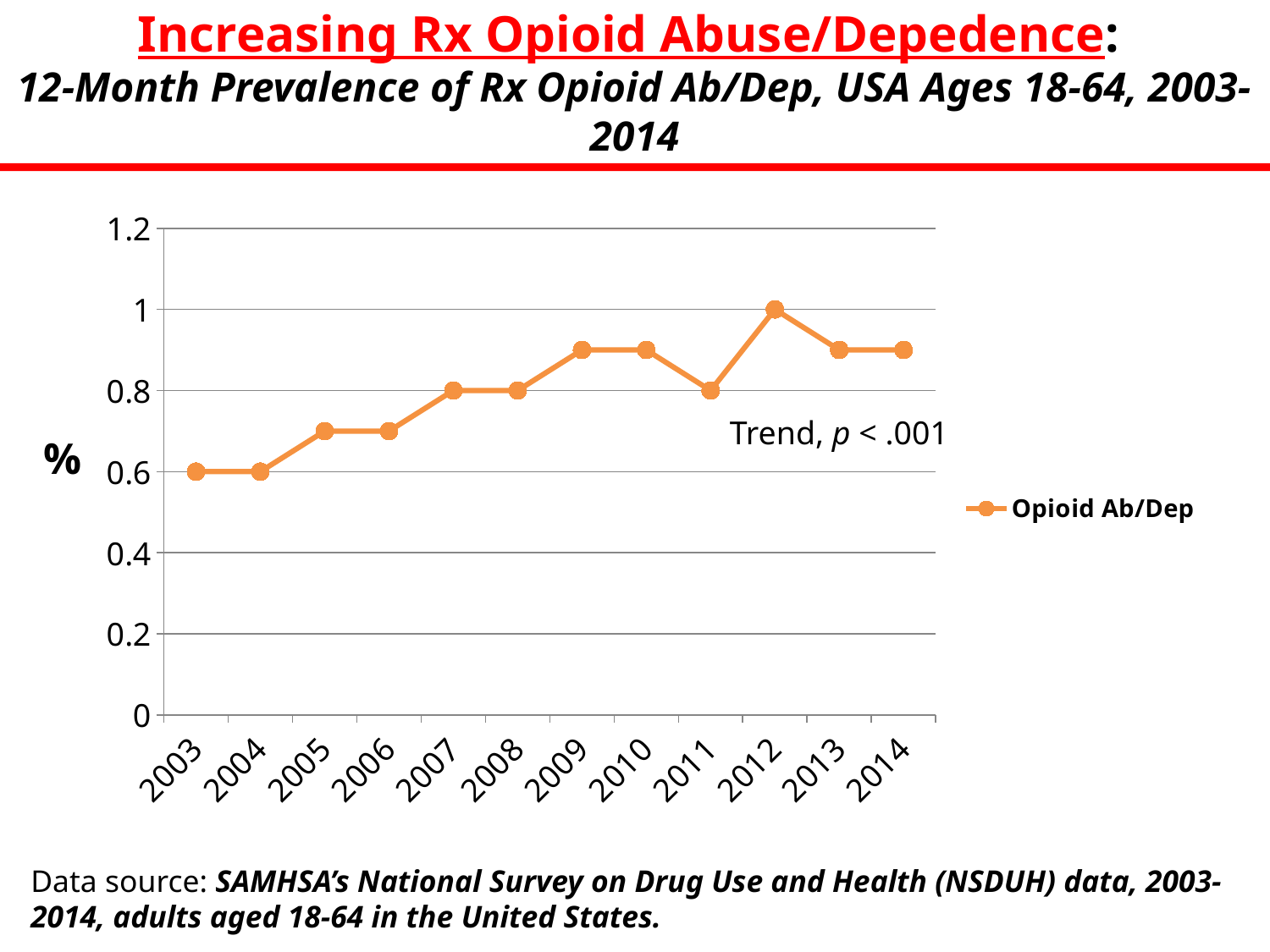
What is the value for 2007? 0.8 Is the value for 2005 greater or less than 0.8? less What is the value for 2003? 0.6 Which is larger, the value for 2012 or the value for 2011? 2012 Which year has the highest value? 2012 What is the value for 2012? 1 Is the value for 2009 greater or less than 0.8? greater Do the values generally rise or fall from 2003 to 2014? rise How many series does the legend list? 1 How many data points are plotted on the chart? 12 What is the difference between the value for 2012 and the value for 2003? 0.4 What kind of chart is shown on the slide? line chart